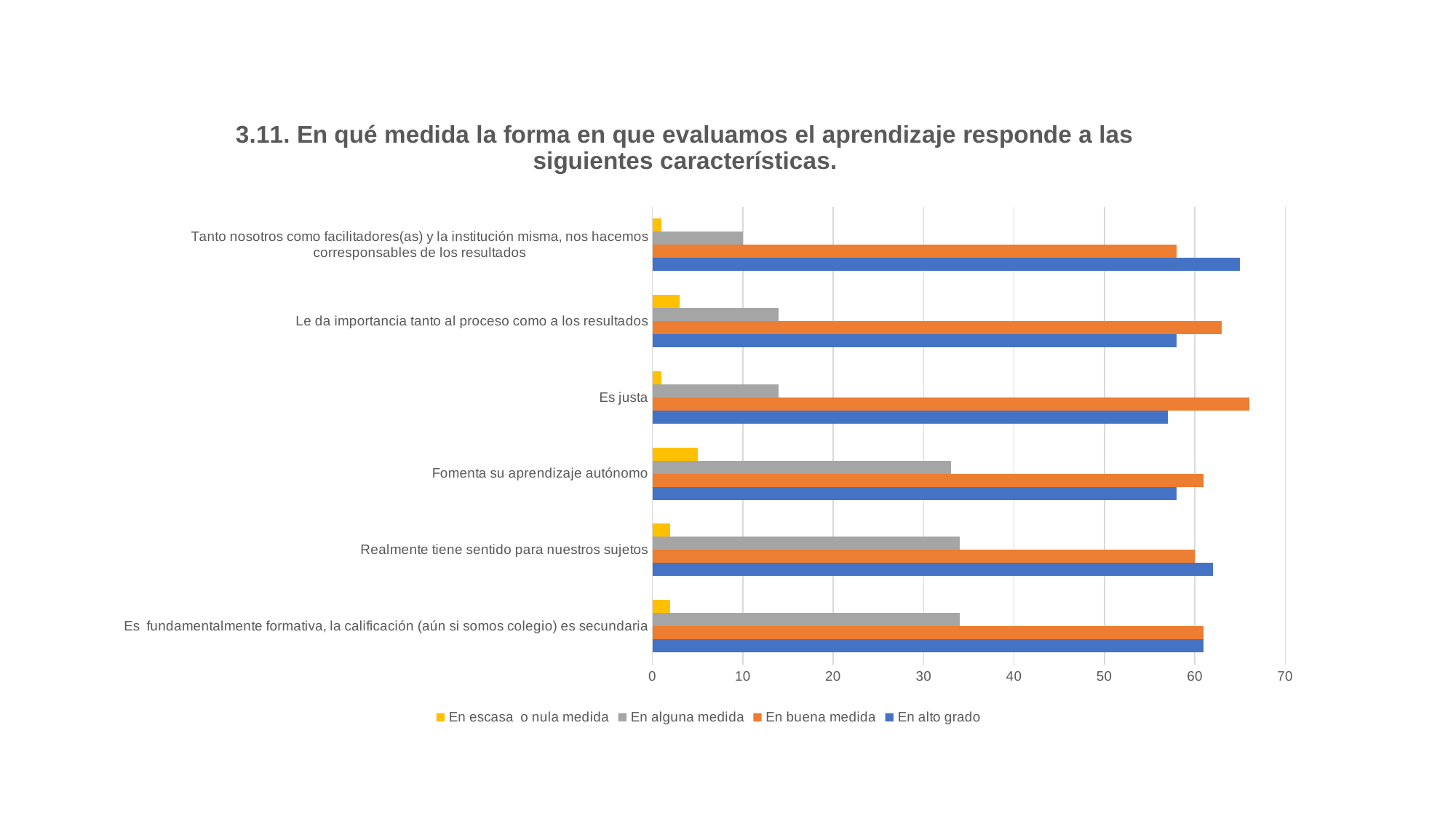
What colour represents the "En alto grado" series in the legend? Blue What kind of chart is shown on the slide? Bar chart How many series does the legend list? 4 Is the value of "En alto grado" for "Tanto nosotros como facilitadores(as) y la institución misma, nos hacemos corresponsables de los resultados" greater or less than 60? greater Is the value of "En alguna medida" for "Fomenta su aprendizaje autónomo" greater or less than 30? greater Is the value of "En alguna medida" for "Tanto nosotros como facilitadores(as) y la institución misma, nos hacemos corresponsables de los resultados" greater or less than 20? less For "Es justa", which is larger: "En buena medida" or "En alto grado"? En buena medida How many categories (characteristics) are plotted on the chart? 6 For "Tanto nosotros como facilitadores(as) y la institución misma, nos hacemos corresponsables de los resultados", which is larger: "En buena medida" or "En alto grado"? En alto grado Which category has the lowest value for "En alguna medida"? Tanto nosotros como facilitadores(as) y la institución misma, nos hacemos corresponsables de los resultados